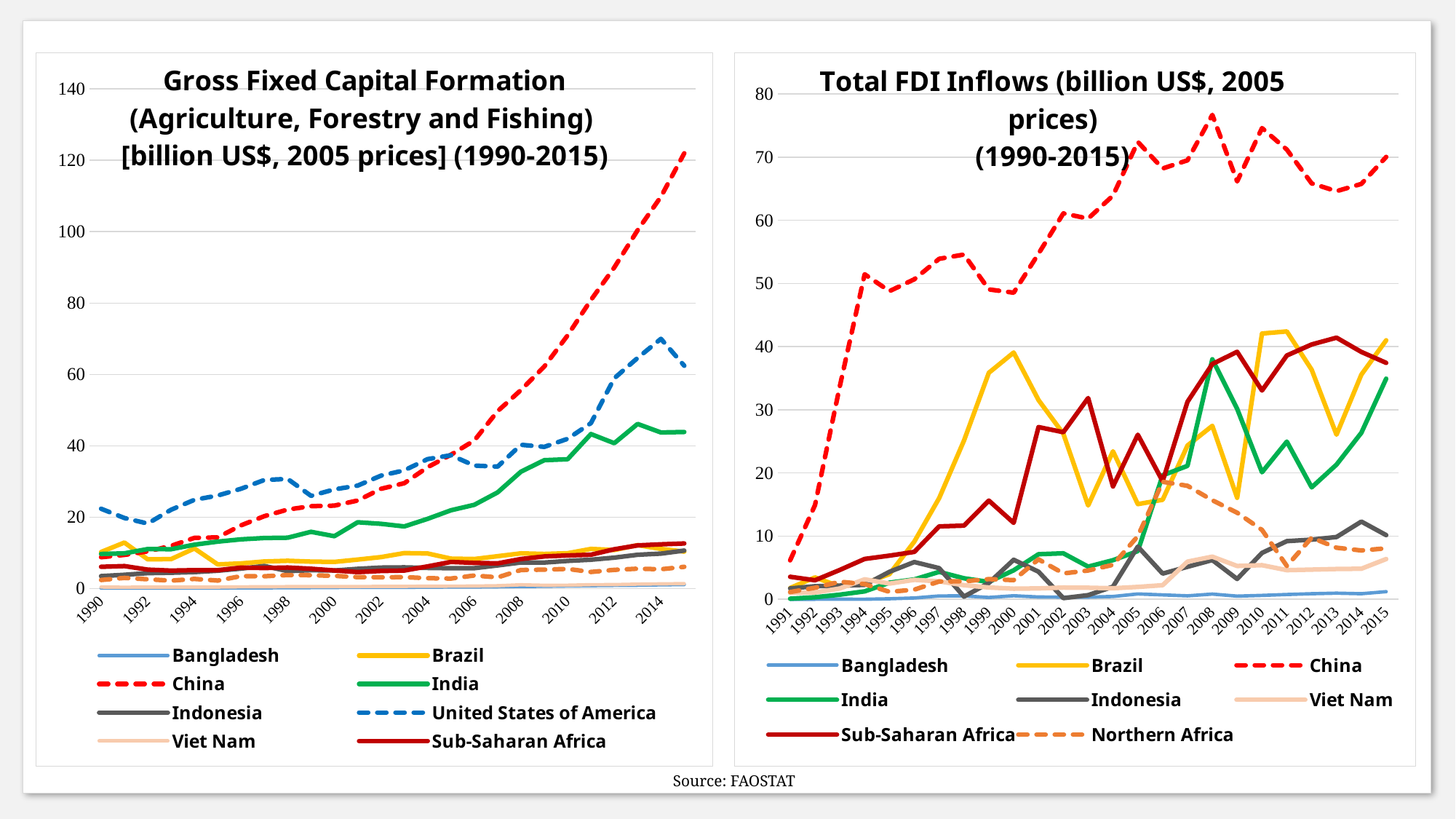
In the 'Total FDI Inflows' chart on the right, is the value for Brazil in 2000 greater or less than 30? greater In the 'Gross Fixed Capital Formation' chart on the left, does the value for China rise or fall from 1990 to 2015? rise What source is cited below the charts? FAOSTAT In the 'Total FDI Inflows' chart on the right, which series has the highest value in 2015? China In the 'Gross Fixed Capital Formation' chart on the left, which is larger in 2015: United States of America or India? United States of America In the 'Gross Fixed Capital Formation' chart on the left, which series has the highest value in 2015? China What kind of chart is the 'Gross Fixed Capital Formation' chart on the left? line chart How many series does the legend of the 'Gross Fixed Capital Formation' chart on the left list? 8 In the 'Gross Fixed Capital Formation' chart on the left, is the value for United States of America in 2014 greater or less than 60? greater How many series does the legend of the 'Total FDI Inflows' chart on the right list? 8 In the 'Total FDI Inflows' chart on the right, is the value for China in 2008 greater or less than 70? greater